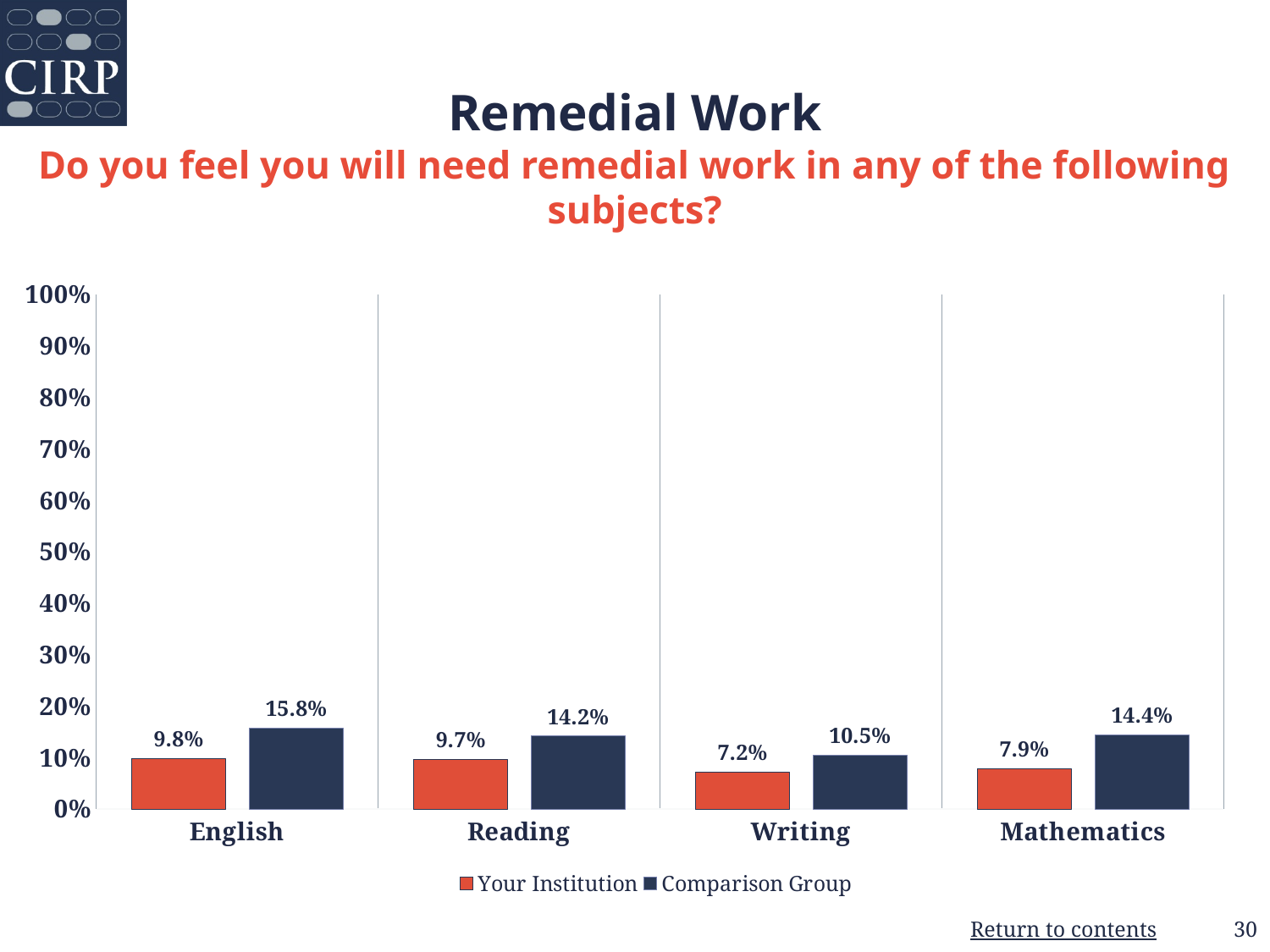
Which is larger for Writing: Your Institution or Comparison Group? Comparison Group Is the Comparison Group value for English greater or less than 20%? less How many subjects are shown on the x axis? 4 What is the value for Comparison Group in Mathematics? 14.4% What is the value for Your Institution in Writing? 7.2% What kind of chart is shown on the slide? bar chart What is the value for Your Institution in English? 9.8% How many series does the legend list? 2 Which subject has the lowest Your Institution value? Writing What is the difference between the Comparison Group and Your Institution values for Reading? 4.5% Which subject has the highest Comparison Group value? English What colour are the Your Institution bars? orange-red